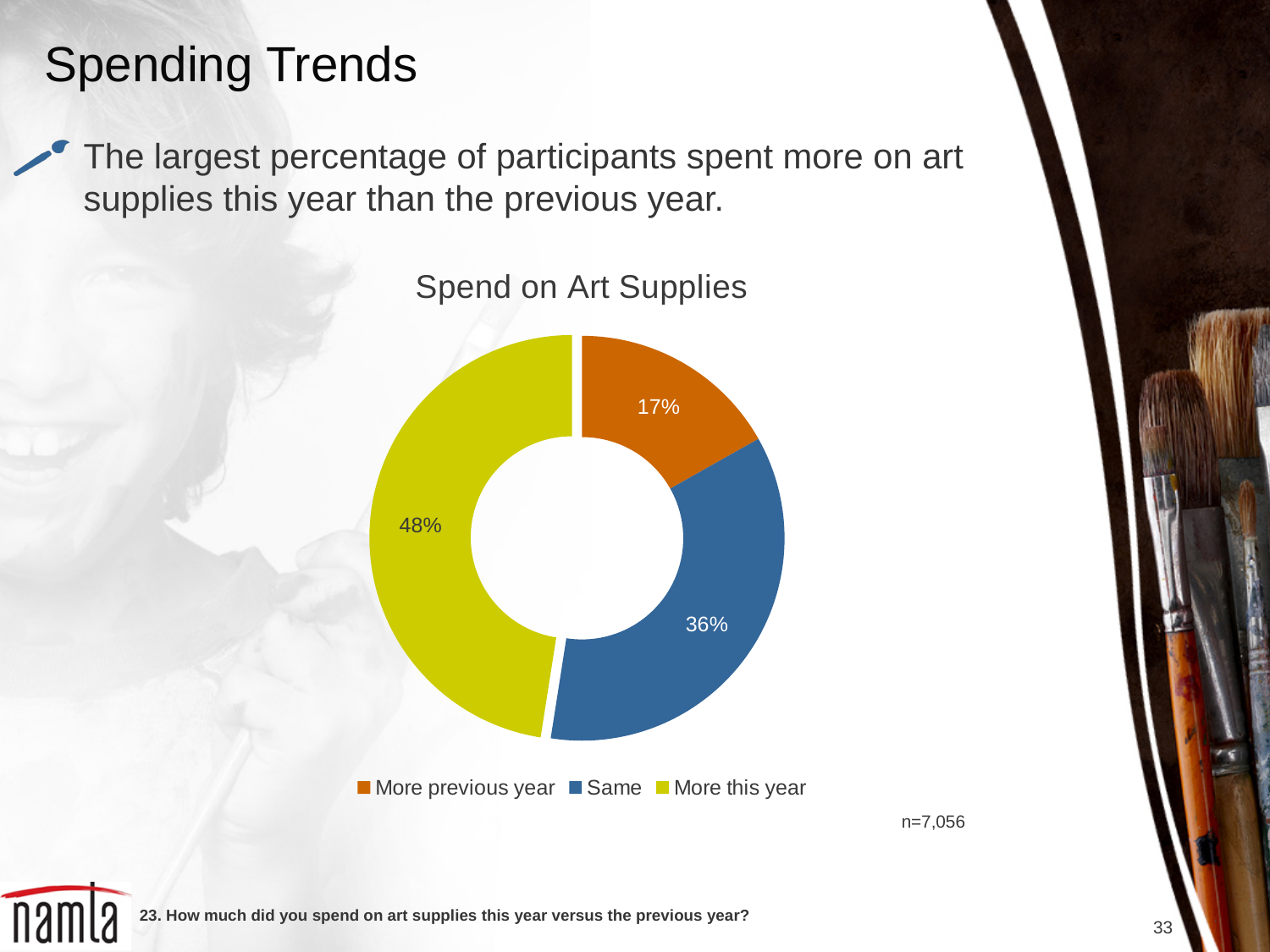
Which category has the largest share of the chart? More this year What percentage of participants spent more on art supplies in the previous year? 17% Which category has the smallest share of the chart? More previous year What percentage of participants spent the same on art supplies as the previous year? 36% What percentage of participants spent more on art supplies this year? 48% What is the title of the chart? Spend on Art Supplies How many categories does the legend list? 3 What kind of chart is shown on the slide? Doughnut (pie) chart What is the difference in percentage points between 'Same' and 'More previous year'? 19 What colour represents 'More this year' in the chart? Yellow-green Which is larger, the share for 'Same' or the share for 'More previous year'? Same What is the difference in percentage points between 'More this year' and 'Same'? 12